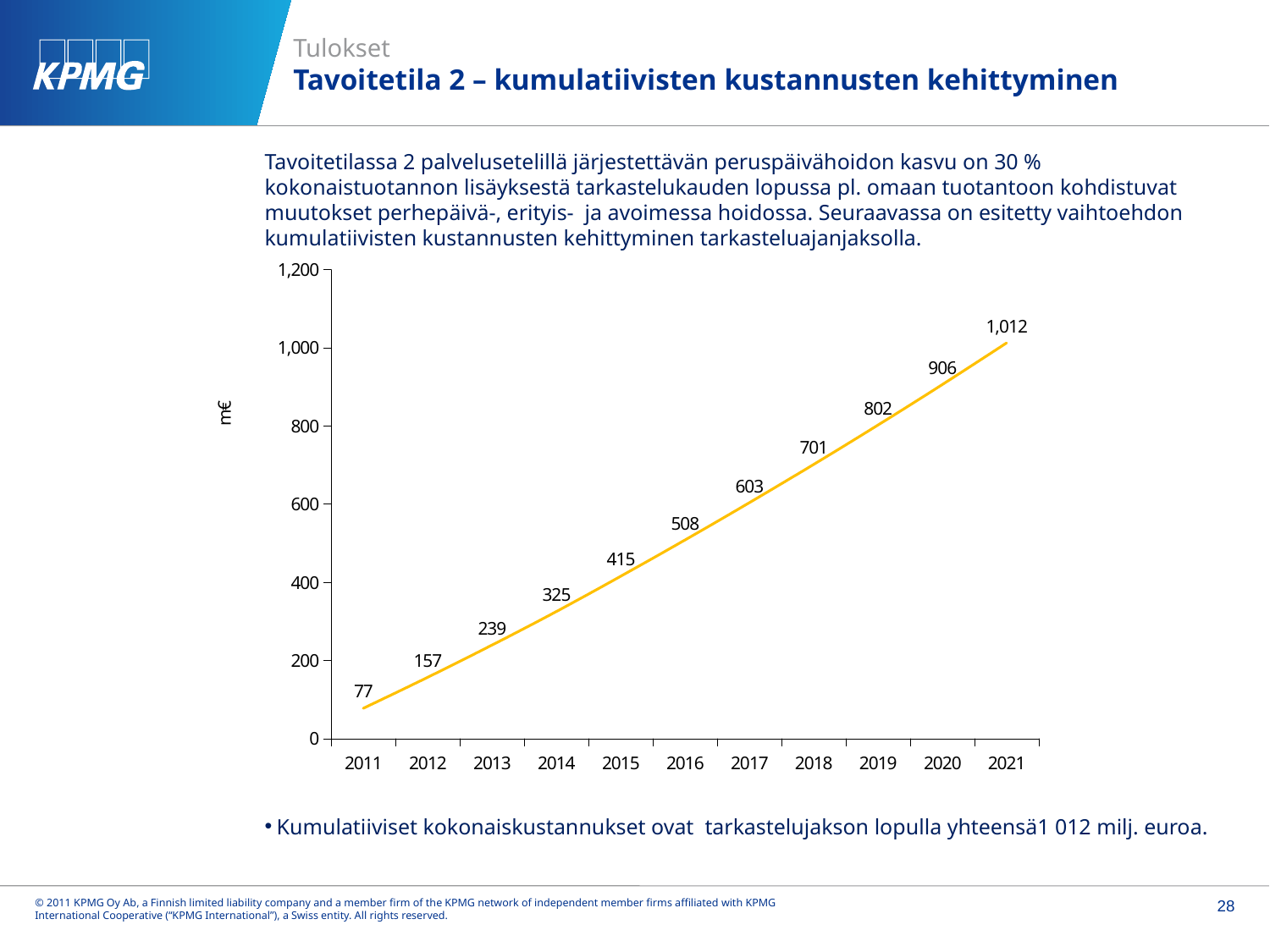
Do the values rise or fall from 2011 to 2021? rise What is the difference between the values for 2021 and 2020? 106 What kind of chart is this? line chart What is the difference between the values for 2015 and 2014? 90 What is the value for 2016? 508 How many years are shown on the x axis? 11 What is the value for 2011? 77 Which is larger, the value for 2017 or the value for 2018? 2018 What is the value for 2019? 802 Which year has the lowest value? 2011 Which year has the highest value? 2021 What is the value for 2021? 1,012